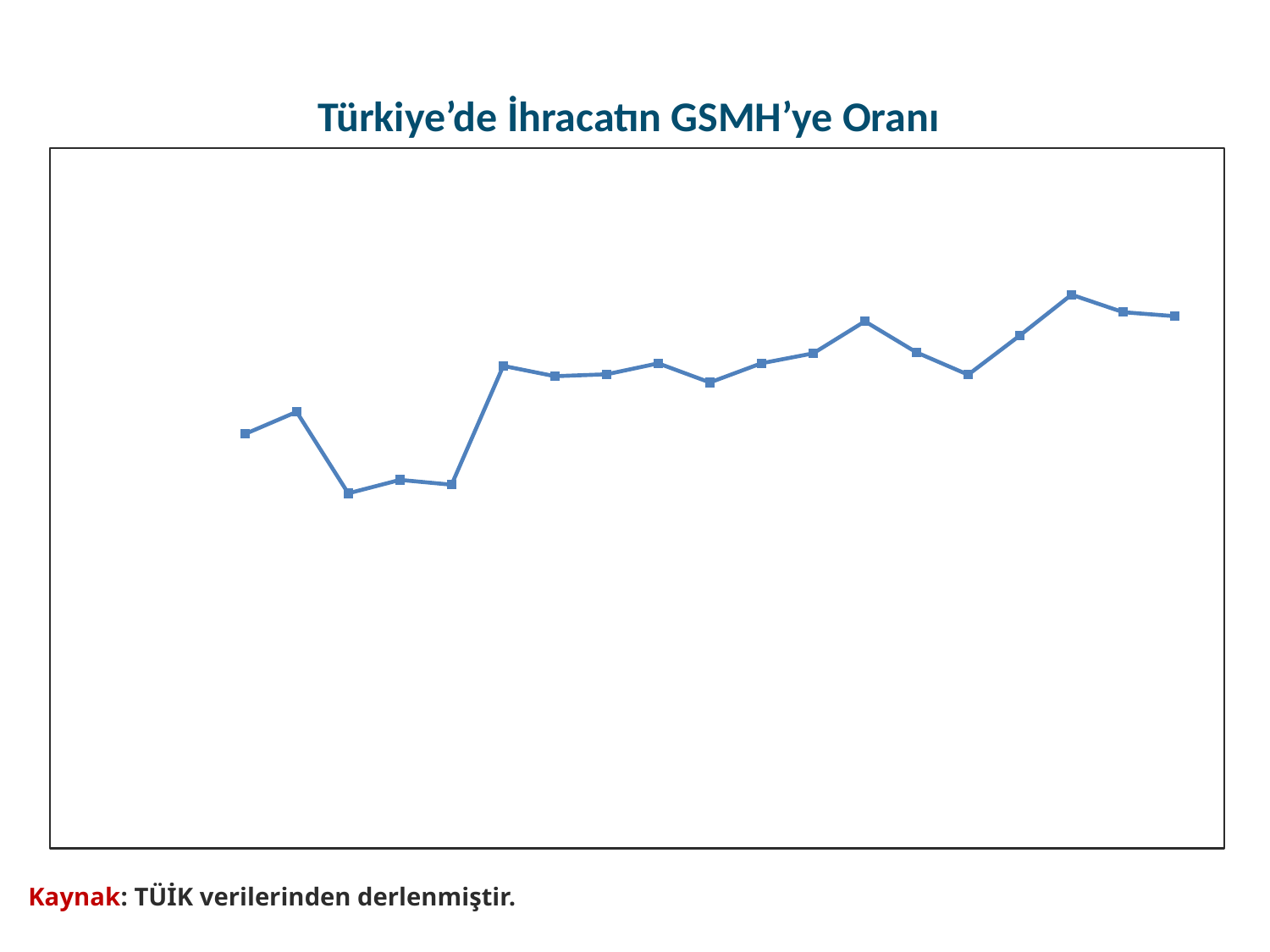
What kind of chart is shown on the slide? line chart Is the rightmost point on the line higher or lower than the leftmost point? higher Is the third point from the left higher or lower than the second point from the left? lower Do the plotted values generally rise or fall from left to right along the x axis? rise What is the title of the chart? Türkiye'de İhracatın GSMH'ye Oranı What source is cited below the chart? TÜİK verilerinden derlenmiştir. How many data points are plotted on the line? 19